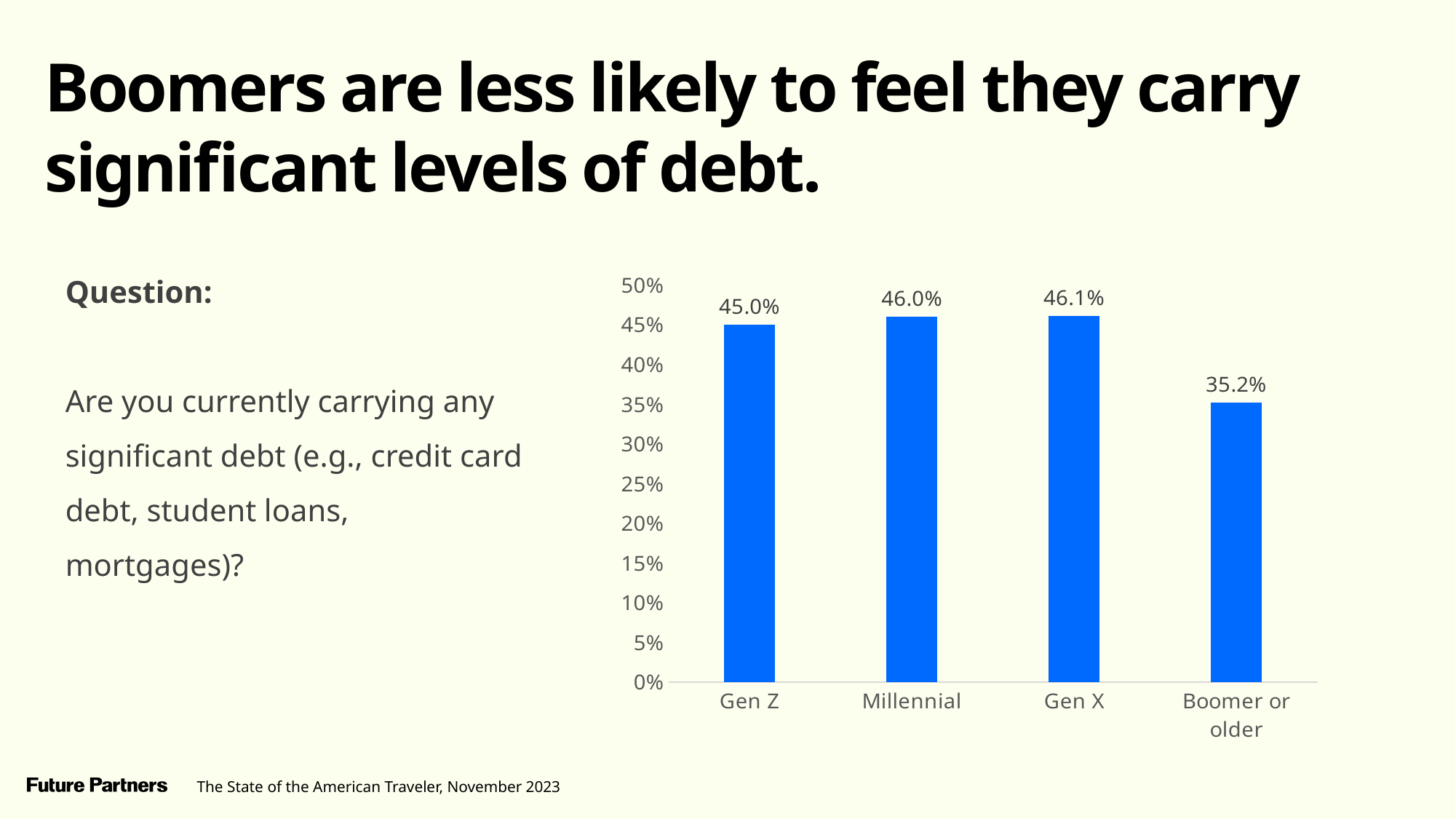
What is the value for Gen Z? 45.0% Which category has the lowest value? Boomer or older What is the value for Gen X? 46.1% What is the difference between the values for Gen X and Boomer or older? 10.9% What is the difference between the values for Millennial and Gen Z? 1.0% Which is larger, the value for Gen Z or the value for Boomer or older? Gen Z What kind of chart is shown on the slide? bar chart What is the value for Boomer or older? 35.2% Is the value for Boomer or older greater or less than 40%? less What is the highest value shown on the y axis? 50% How many categories are shown on the x axis? 4 What is the value for Millennial? 46.0%